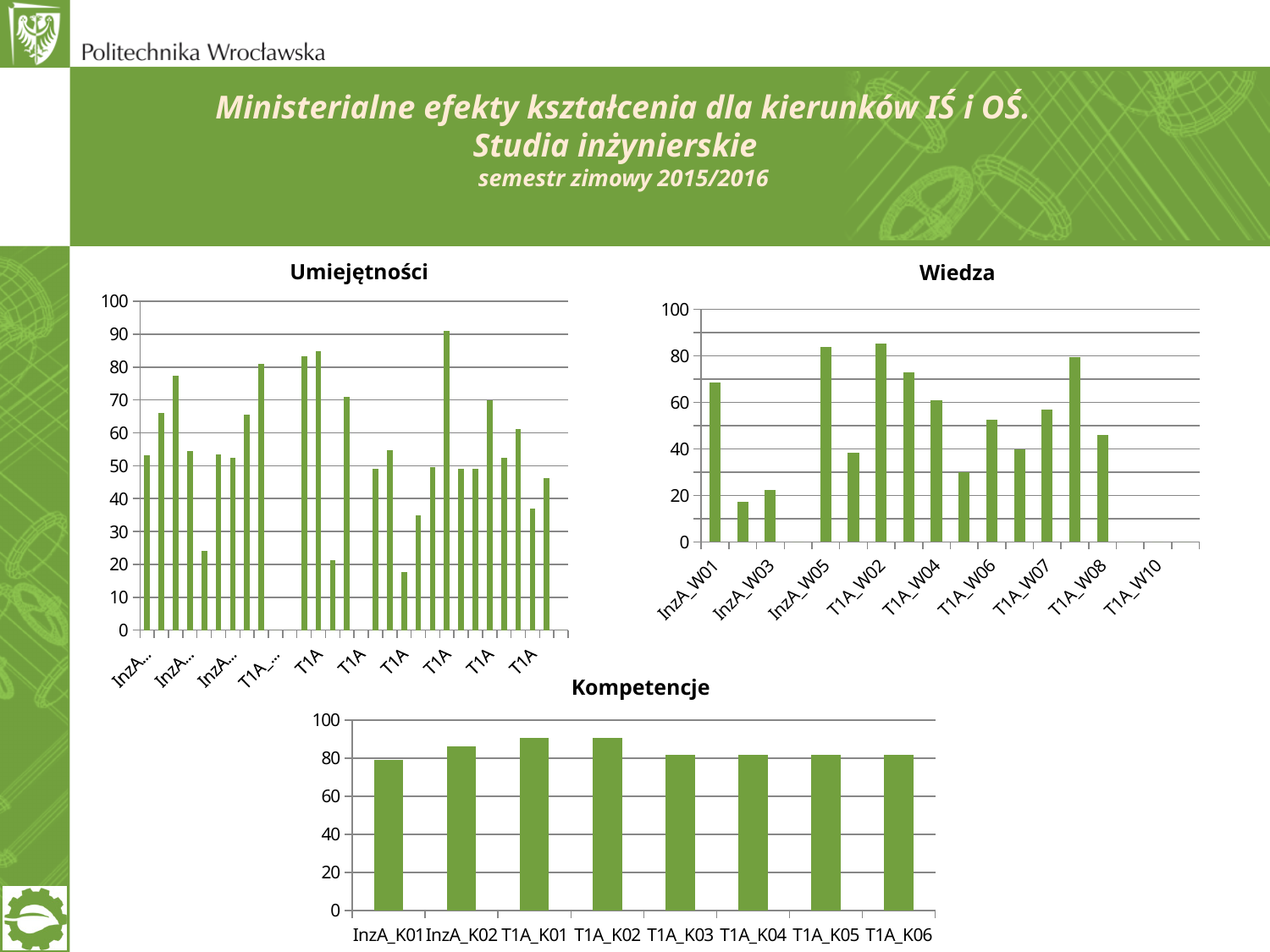
How many categories are shown on the Kompetencje chart? 8 What are the titles of the three charts on the slide? Umiejętności, Wiedza, Kompetencje What kind of chart is the Kompetencje chart? bar chart On the Kompetencje chart, which is larger, the value for T1A_K01 or the value for T1A_K03? T1A_K01 On the Kompetencje chart, which is larger, the value for InzA_K01 or the value for InzA_K02? InzA_K02 On the Kompetencje chart, is the value for InzA_K02 greater or less than 80? greater On the Wiedza chart, is the value for InzA_W01 greater or less than 80? less On the Kompetencje chart, is the value for T1A_K01 greater or less than 80? greater On the Kompetencje chart, which category has the lowest value? InzA_K01 What kind of chart is the Umiejętności chart? bar chart